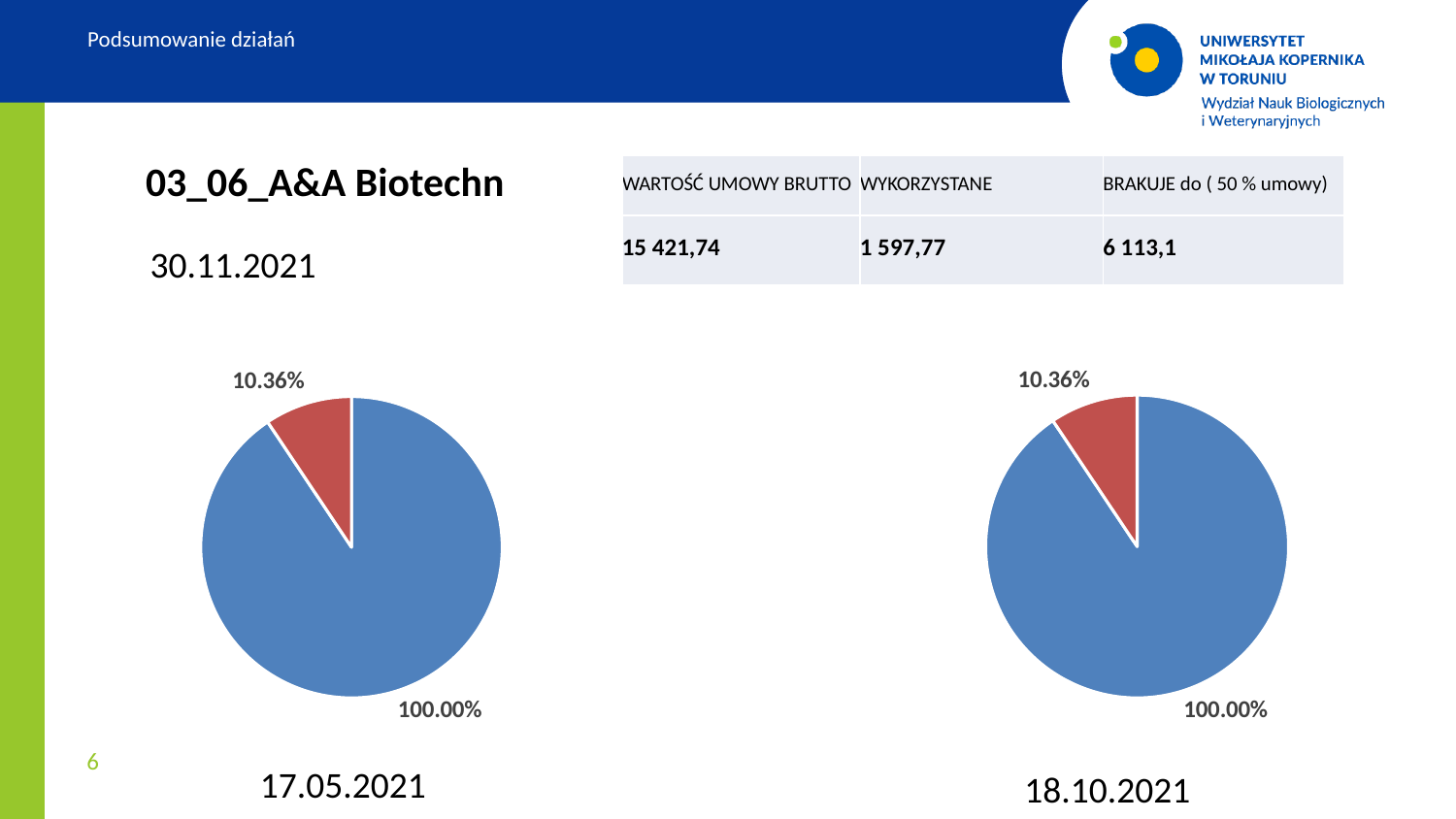
In the right pie chart (18.10.2021), how many slices does the pie have? 2 In the left pie chart (17.05.2021), what percentage label is shown on the red slice? 10.36% What date is written below the left pie chart? 17.05.2021 In the left pie chart (17.05.2021), what is the label of the largest slice? 100.00% In the left pie chart (17.05.2021), which slice is larger, the red one or the blue one? the blue one In the left pie chart (17.05.2021), how many slices does the pie have? 2 What type of chart is shown on the left side of the slide, above the date 17.05.2021? pie chart In the right pie chart (18.10.2021), what percentage label is shown on the blue slice? 100.00% What type of chart is shown on the right side of the slide, above the date 18.10.2021? pie chart In the right pie chart (18.10.2021), what is the label of the smallest slice? 10.36% What date is written below the right pie chart? 18.10.2021 Is the red slice label in the left pie chart (17.05.2021) the same as the red slice label in the right pie chart (18.10.2021)? yes